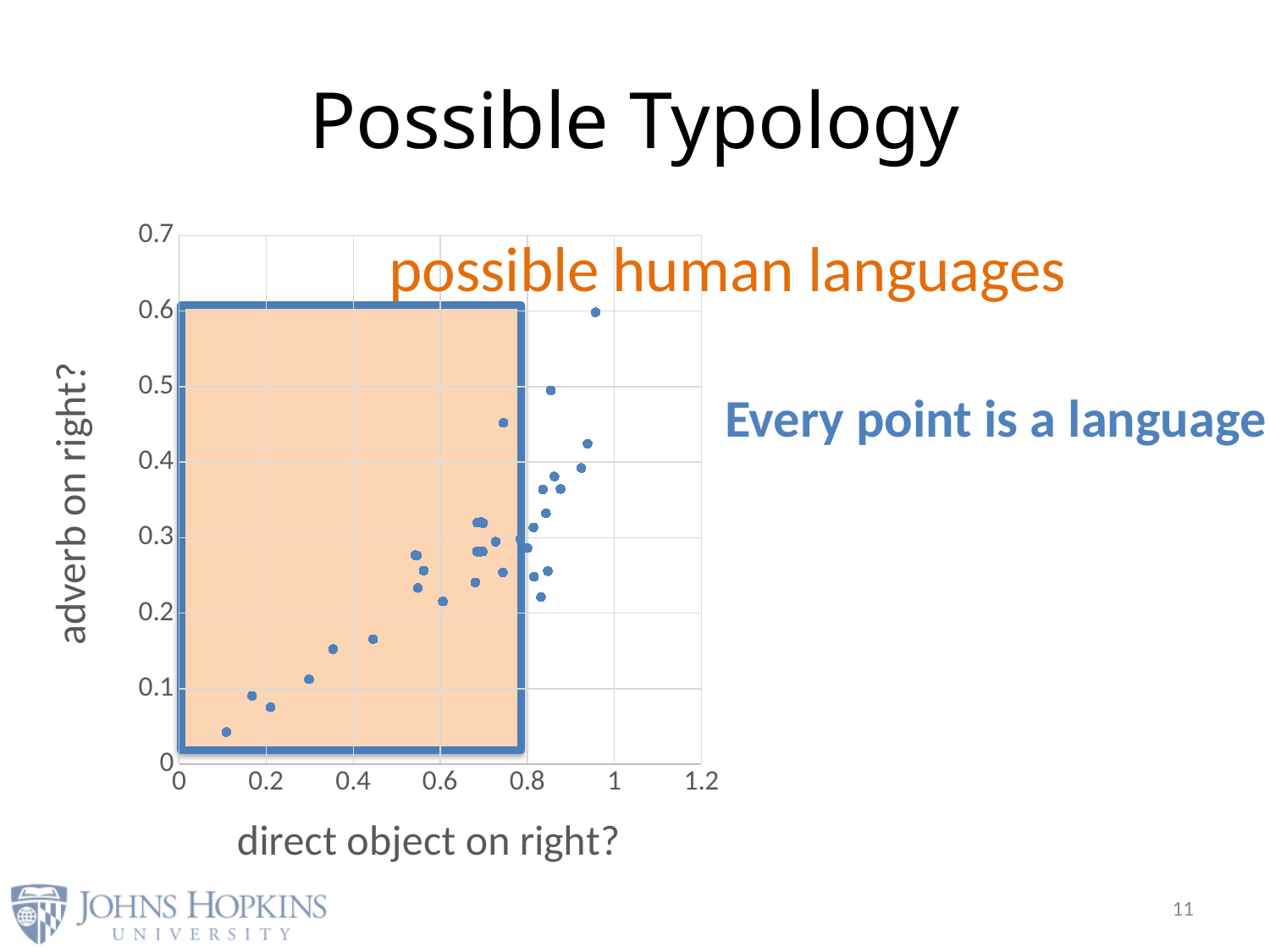
Is the x value of the leftmost point on the chart greater or less than 0.2? less What is the label of the x axis of the chart? direct object on right? What is the largest tick value shown on the y axis? 0.7 Is the y value of the lowest point on the chart greater or less than 0.1? less Is the x value of the rightmost point on the chart greater or less than 1? less What is the label of the y axis of the chart? adverb on right? Do the y values of the points generally rise or fall as the x value increases? rise What kind of chart is shown on the slide? scatter plot What is the largest tick value shown on the x axis? 1.2